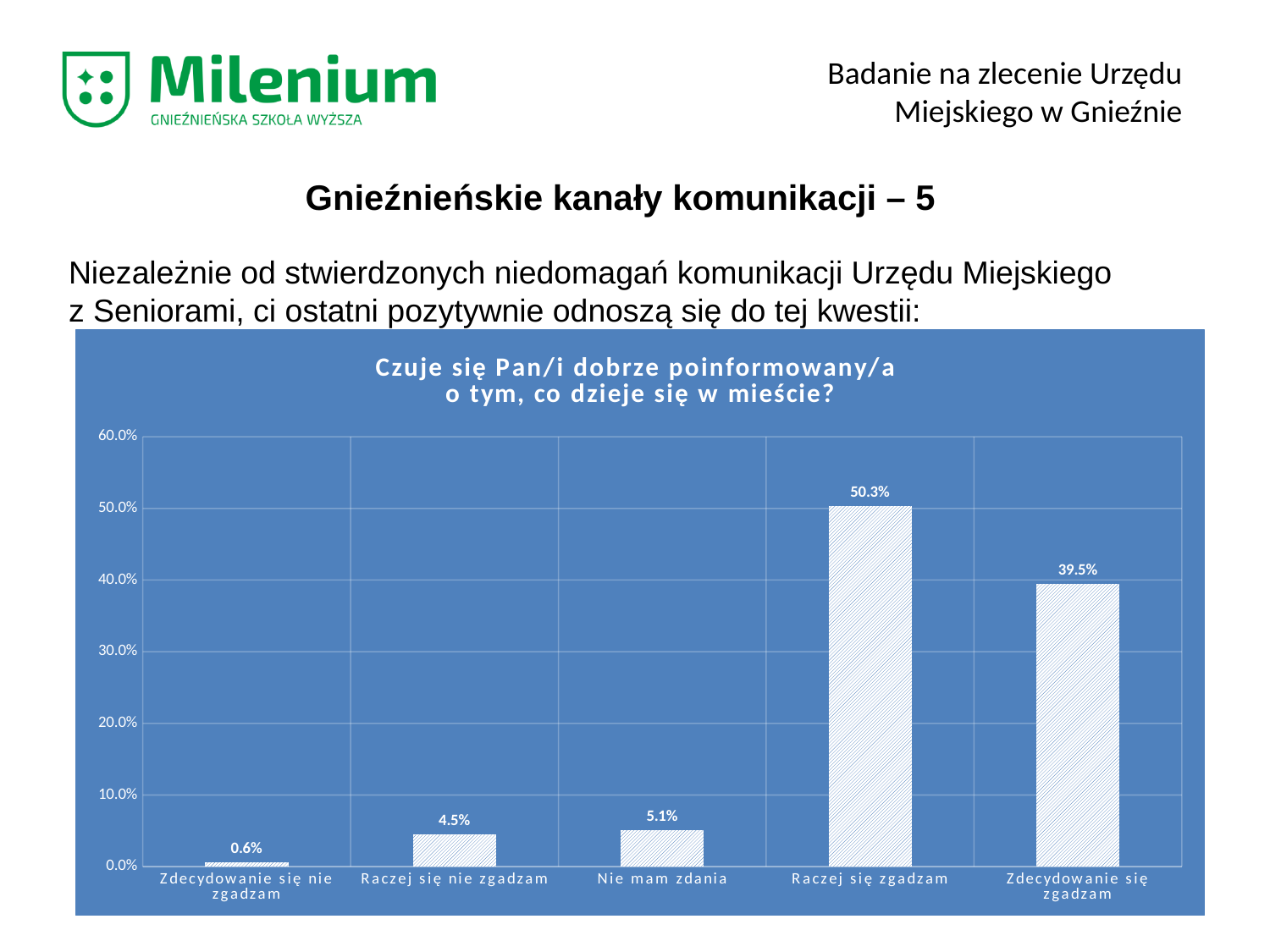
Which category has the lowest value? Zdecydowanie się nie zgadzam What is the value for "Nie mam zdania"? 5.1% What is the value for "Raczej się zgadzam"? 50.3% Which category has the highest value? Raczej się zgadzam What is the value for "Zdecydowanie się nie zgadzam"? 0.6% How many categories are shown on the x axis? 5 What is the value for "Zdecydowanie się zgadzam"? 39.5% What is the title of the chart? Czuje się Pan/i dobrze poinformowany/a o tym, co dzieje się w mieście? Is the value for "Zdecydowanie się zgadzam" greater or less than 30.0%? greater Which is larger, the value for "Raczej się nie zgadzam" or the value for "Nie mam zdania"? Nie mam zdania What kind of chart is shown on the slide? bar chart What is the difference between the values for "Raczej się zgadzam" and "Zdecydowanie się zgadzam"? 10.8%